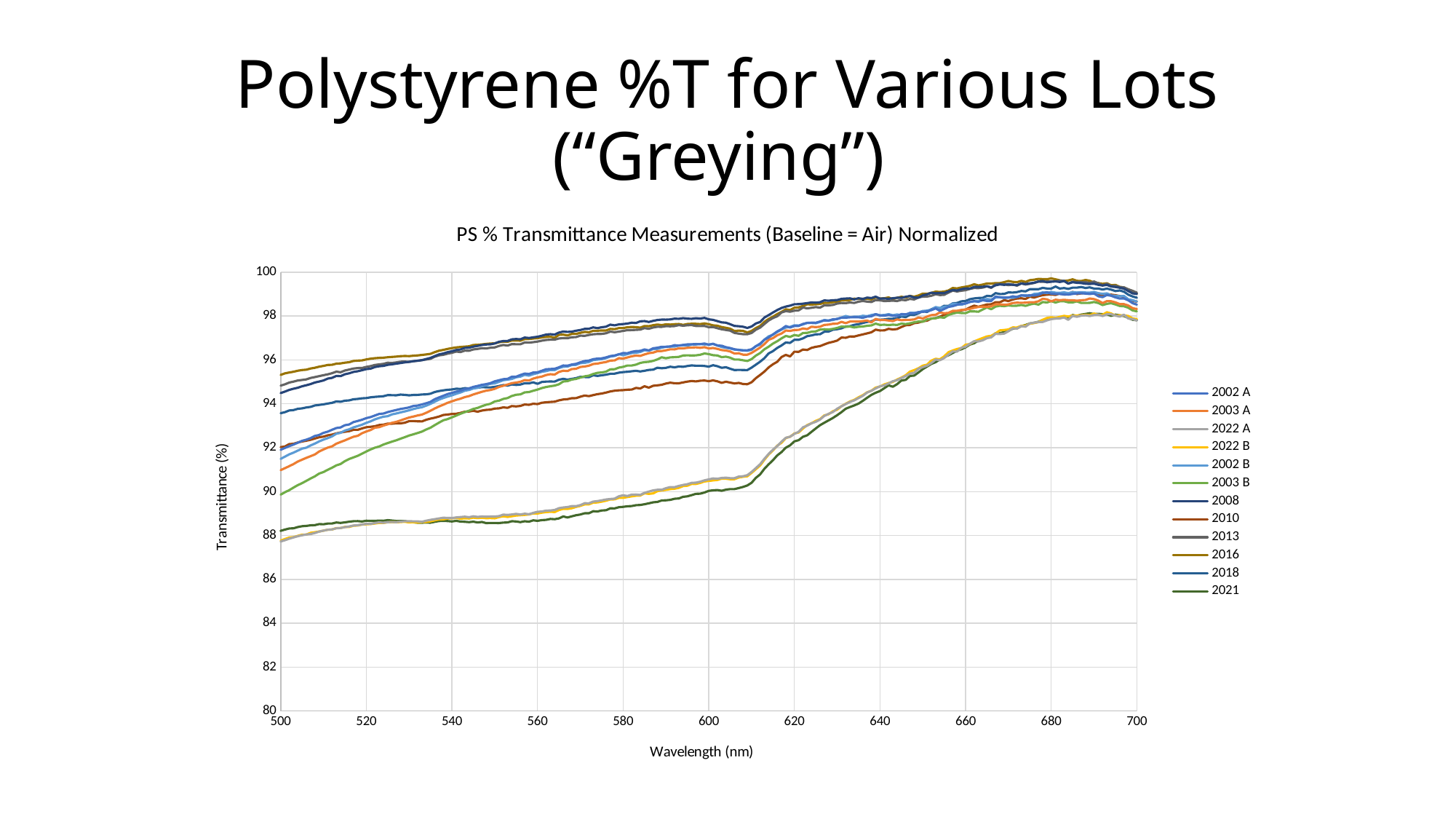
What is the title of the chart? PS % Transmittance Measurements (Baseline = Air) Normalized What kind of chart is shown on the slide? line chart At 600 nm, which series has the higher transmittance, 2008 or 2010? 2008 At 500 nm, which series has the higher transmittance, 2016 or 2021? 2016 Is the value for the 2010 series at 600 nm greater or less than 96? less Is the value for the 2021 series at 500 nm greater or less than 90? less Is the value for the 2022 A series at 600 nm greater or less than 92? less Does the transmittance for the 2021 series rise or fall as wavelength increases from 500 to 700 nm? rise What is the label of the x axis? Wavelength (nm) How many series does the legend list? 12